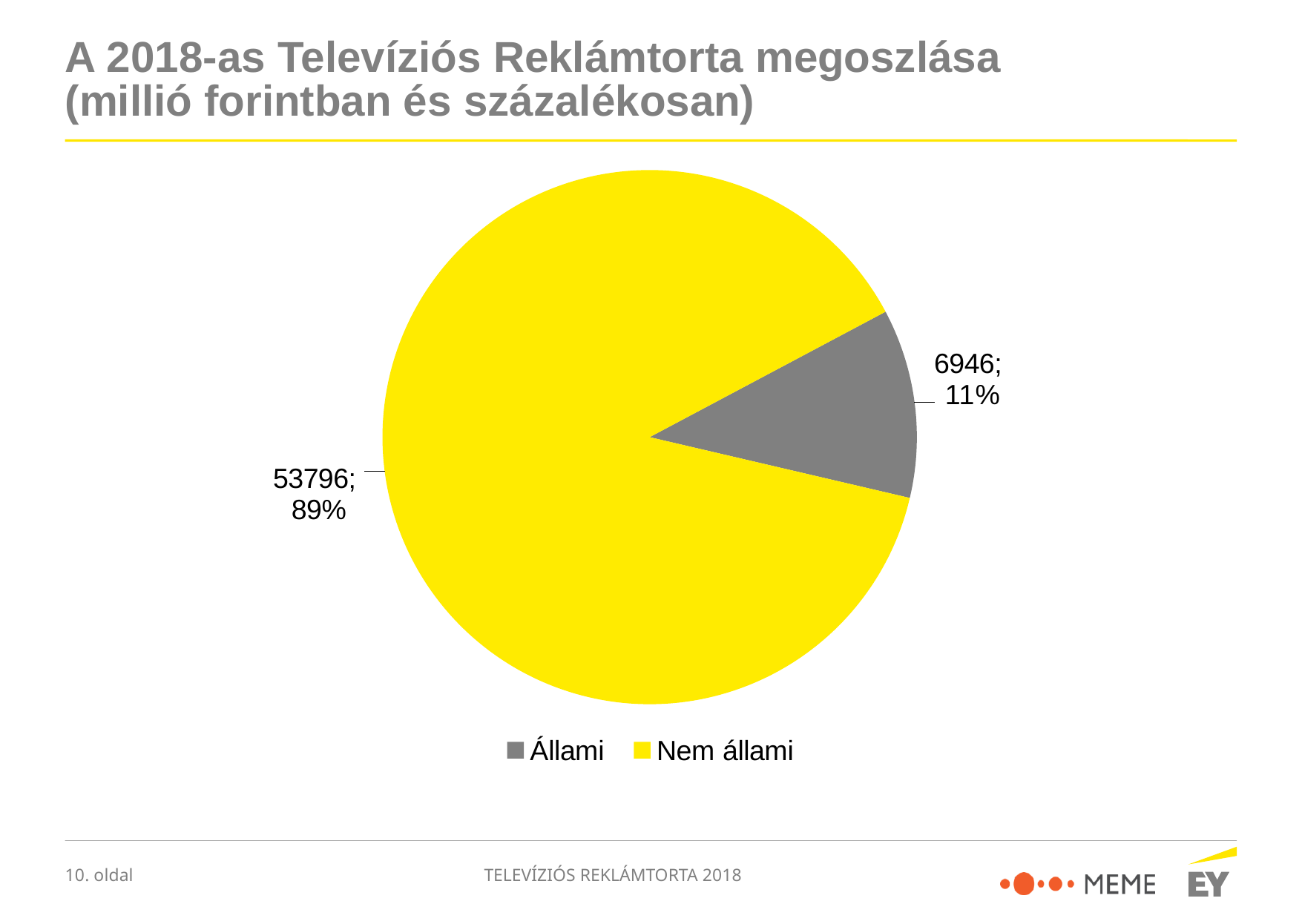
What share of the pie does the Állami slice represent? 11% How many entries does the legend list? 2 Which is larger, the value for Állami or the value for Nem állami? Nem állami Which category has the largest slice? Nem állami What share of the pie does the Nem állami slice represent? 89% What is the difference between the Nem állami and Állami values? 46850 What is the value for Állami? 6946 How many slices does the pie chart have? 2 Which category has the smallest slice? Állami What kind of chart is shown on the slide? pie chart What is the value for Nem állami? 53796 What colour is the Állami slice? grey